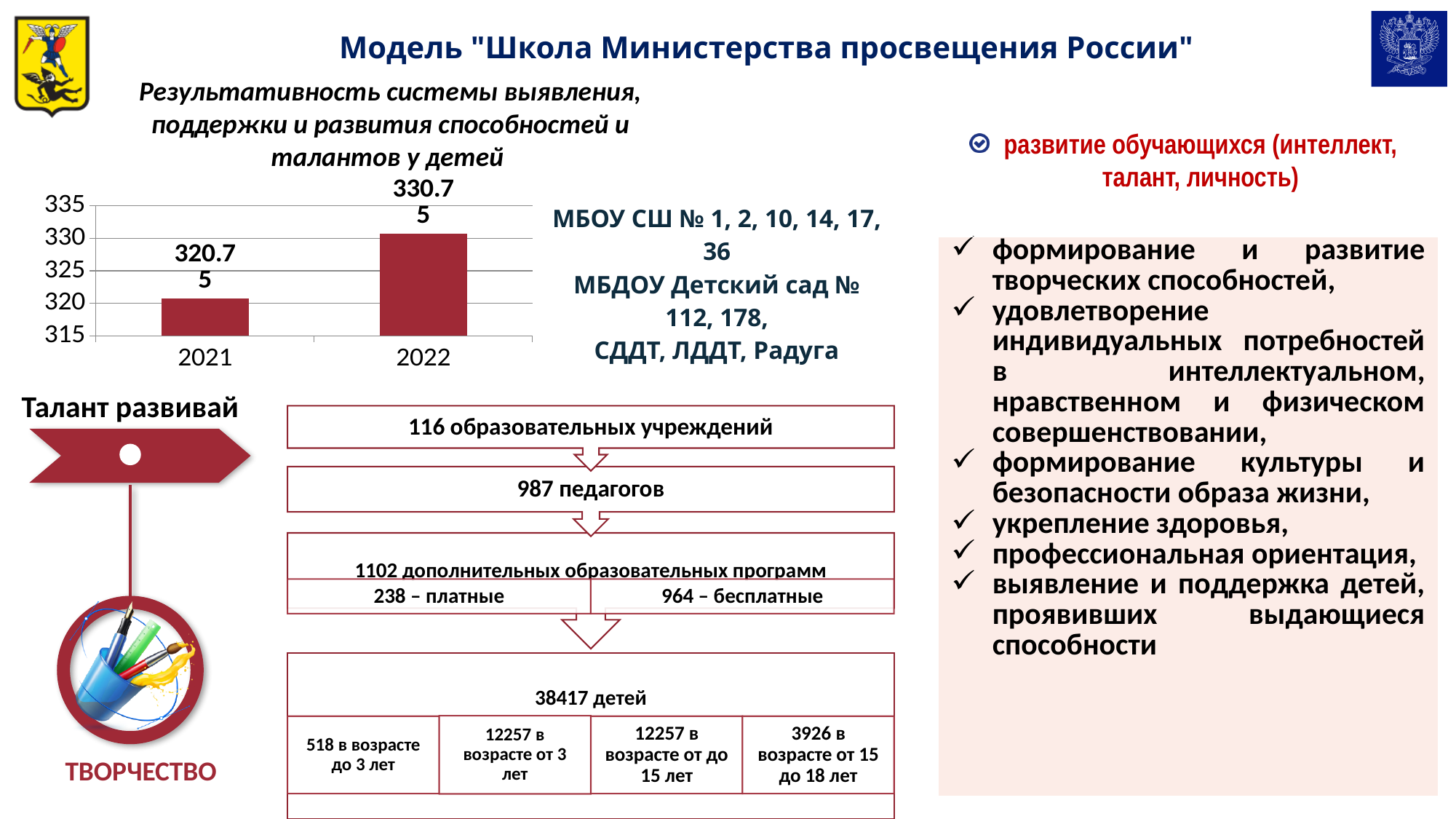
Do the values in the bar chart rise or fall from 2021 to 2022? rise Which year has the highest value in the bar chart? 2022 Is the value for 2022 in the bar chart greater or less than 330? greater What is the value for 2022 in the bar chart? 330.75 How many years are shown on the x axis of the bar chart? 2 What is the value for 2021 in the bar chart? 320.75 Is the value for 2021 in the bar chart greater or less than 325? less What is the title of the bar chart? Результативность системы выявления, поддержки и развития способностей и талантов у детей What is the difference between the values for 2022 and 2021 in the bar chart? 10 What kind of chart is shown on the slide? bar chart Which is larger in the bar chart, the value for 2021 or the value for 2022? 2022 Which year has the lowest value in the bar chart? 2021